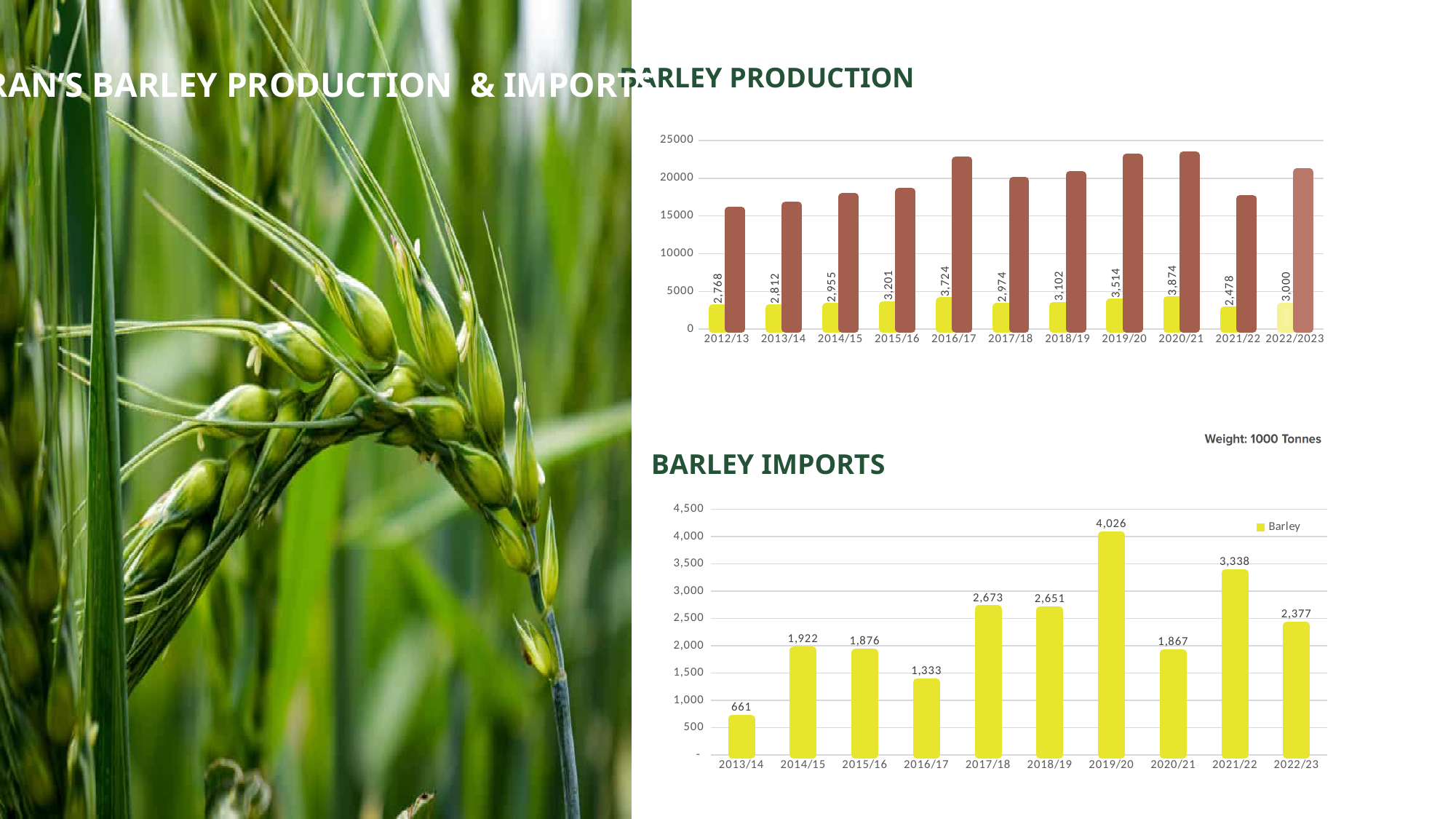
In the BARLEY PRODUCTION chart, is the brown bar for 2019/20 greater or less than 20000? greater In the BARLEY PRODUCTION chart, what value is labelled on the yellow bar for 2016/17? 3,724 What series name does the legend of the BARLEY IMPORTS chart show? Barley How many years are shown on the x axis of the BARLEY PRODUCTION chart? 11 In the BARLEY PRODUCTION chart, is the brown bar for 2012/13 greater or less than 20000? less In the BARLEY IMPORTS chart, what is the value for 2019/20? 4,026 What kind of chart is the BARLEY IMPORTS chart? Bar chart In the BARLEY IMPORTS chart, which year has the lowest value? 2013/14 In the BARLEY IMPORTS chart, what is the difference between the values for 2021/22 and 2022/23? 961 In the BARLEY PRODUCTION chart, which year has the lowest labelled yellow-bar value? 2021/22 In the BARLEY PRODUCTION chart, what value is labelled on the yellow bar for 2020/21? 3,874 In the BARLEY IMPORTS chart, which is larger, the value for 2017/18 or the value for 2016/17? 2017/18